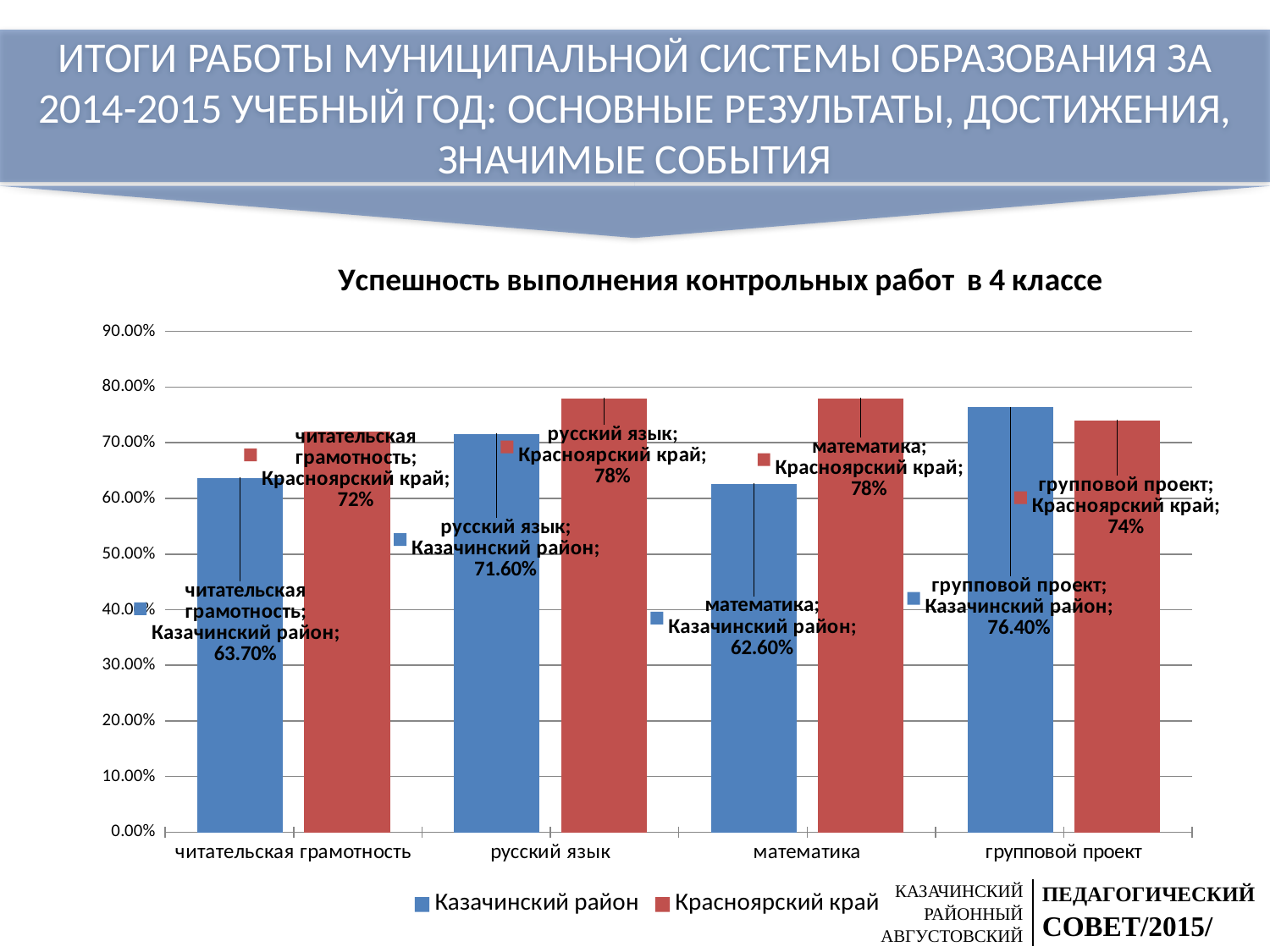
In the групповой проект category, which series has the larger value: Казачинский район or Красноярский край? Казачинский район In which category does Красноярский край have its lowest value? читательская грамотность In which category does Казачинский район have its highest value? групповой проект What is the value for Казачинский район in the групповой проект category? 76.40% What is the value for Казачинский район in the читательская грамотность category? 63.70% In which category does Казачинский район have its lowest value? математика What is the value for Красноярский край in the читательская грамотность category? 72% What kind of chart is shown on the slide? bar chart What is the value for Красноярский край in the математика category? 78% What is the difference between Красноярский край and Казачинский район in the математика category? 15.40 percentage points How many series does the legend list? 2 How many categories are shown on the x axis? 4